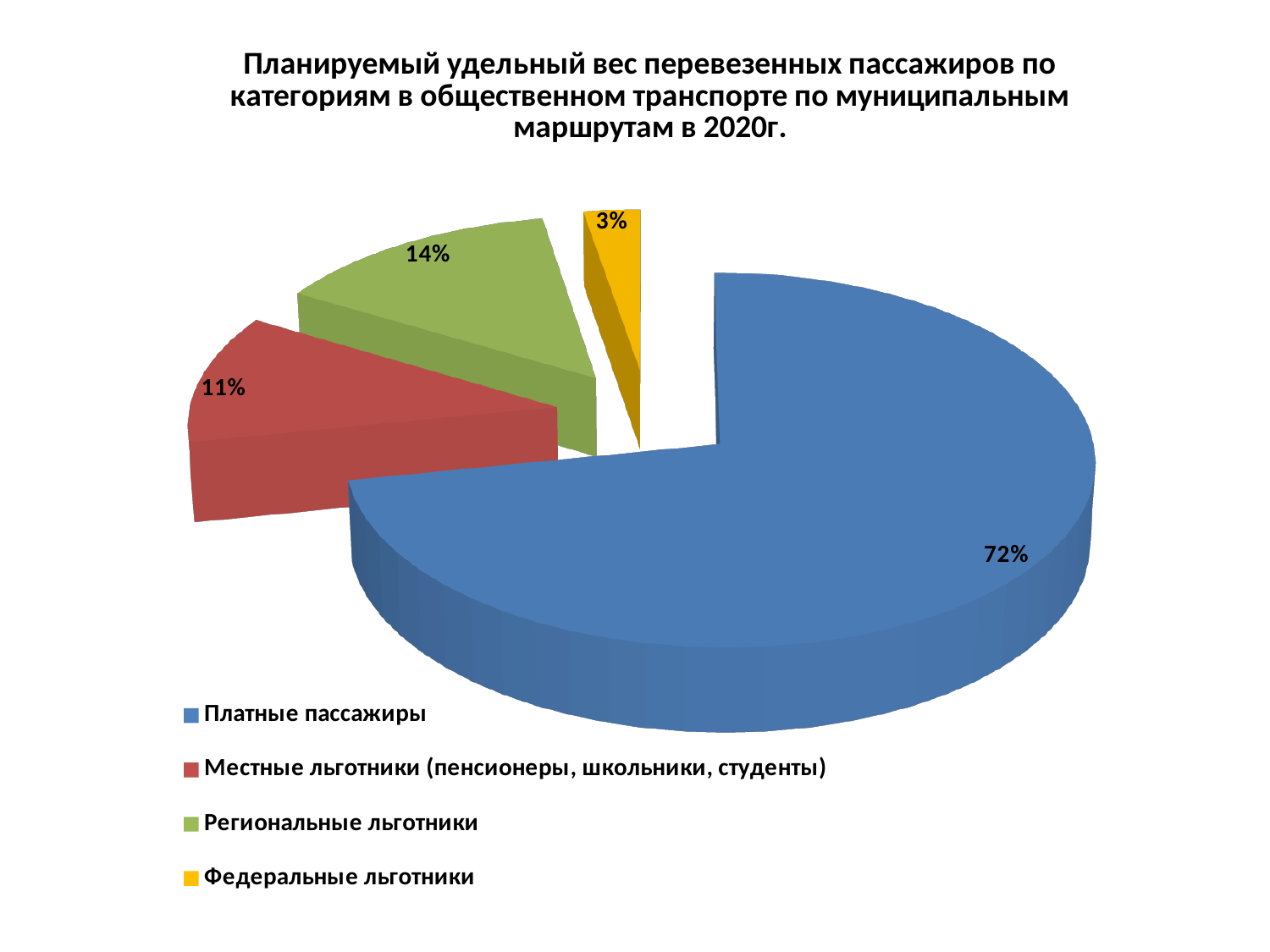
What share is shown for Федеральные льготники? 3% What share is shown for Региональные льготники? 14% Which is larger: the share for Региональные льготники or for Местные льготники? Региональные льготники Which category has the largest share of the pie? Платные пассажиры What share is shown for Местные льготники (пенсионеры, школьники, студенты)? 11% How many categories are shown in the pie chart? 4 What colour is the slice for Федеральные льготники? Yellow Which category has the smallest share of the pie? Федеральные льготники What is the difference in percentage points between Платные пассажиры and Региональные льготники? 58 What share of passengers is planned for Платные пассажиры? 72% What year does the chart title refer to? 2020 What kind of chart is shown on the slide? Pie chart